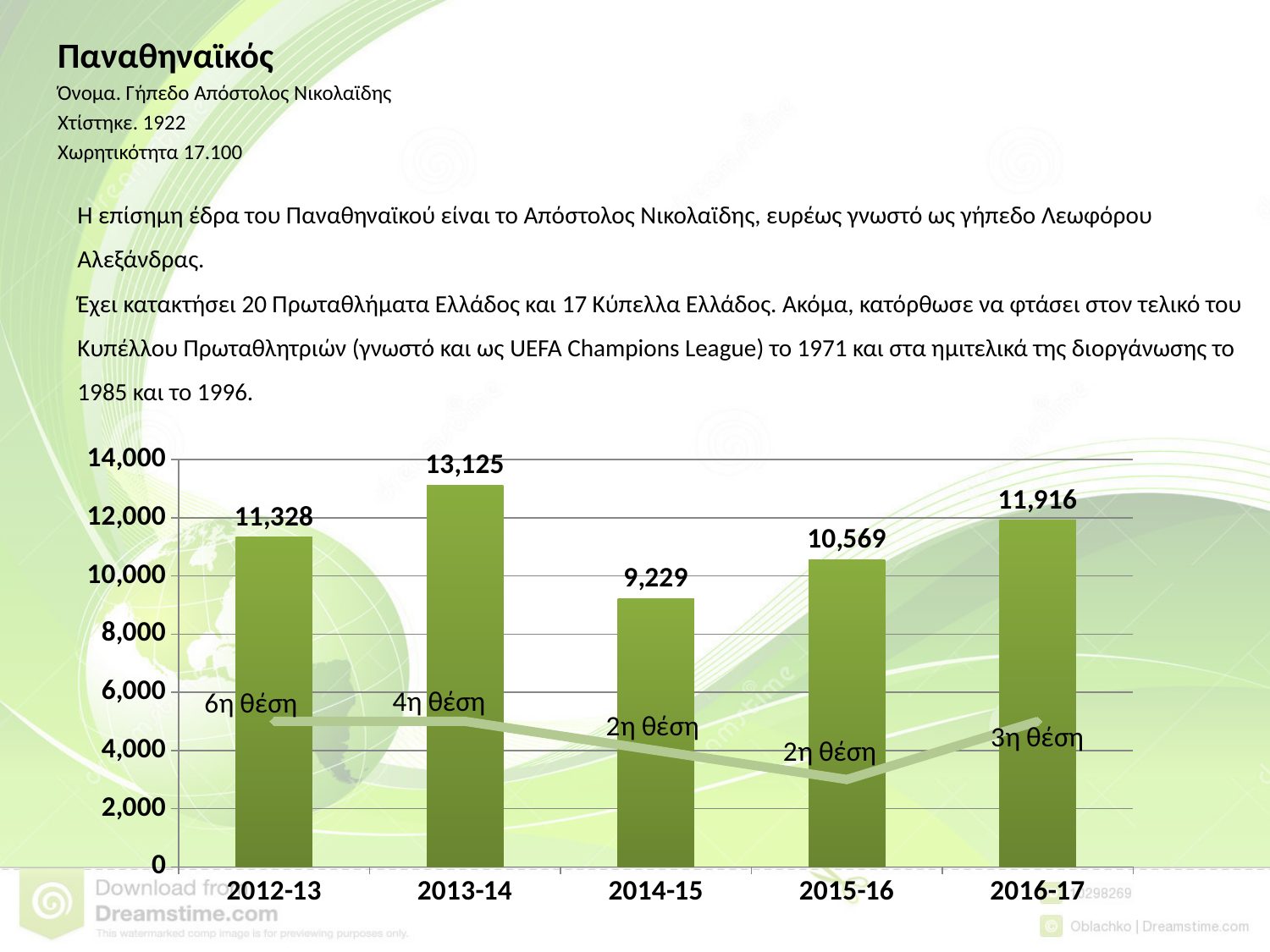
What is the difference between the bar values for 2013-14 and 2014-15? 3,896 What is the value of the bar for 2016-17? 11,916 Which season has a larger bar value, 2012-13 or 2016-17? 2016-17 What kind of chart is shown on the slide? bar chart with a line How many seasons are shown on the x axis of the chart? 5 What is the difference between the bar values for 2016-17 and 2015-16? 1,347 What position label is shown on the line for the 2012-13 season? 6η θέση What is the value of the bar for 2014-15? 9,229 Which season has the highest bar value? 2013-14 Is the bar value for 2015-16 greater or less than 10,000? greater What is the value of the bar for 2013-14? 13,125 Which season has the lowest bar value? 2014-15